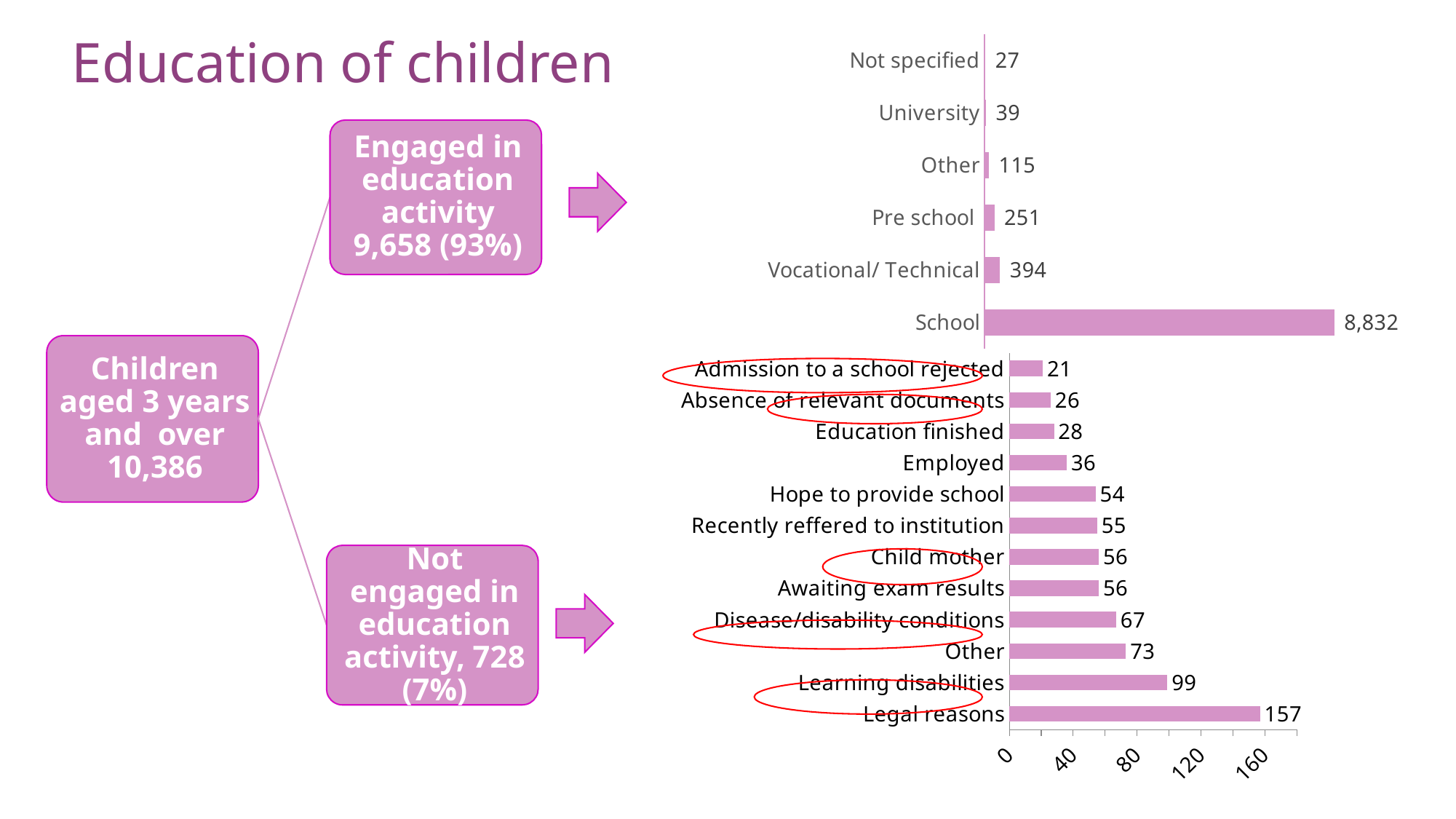
In the top chart, what is the value for Vocational/ Technical? 394 In the top chart, how many categories are shown? 6 In the bottom chart, what is the value for Disease/disability conditions? 67 In the top chart, what is the difference between Pre school and Other? 136 In the bottom chart, how many categories are shown? 12 In the top chart, what is the value for School? 8,832 What kind of chart is the bottom chart? Bar chart In the bottom chart, which is larger: Learning disabilities or Other? Learning disabilities In the top chart, which category has the lowest value? Not specified In the bottom chart, which category has the lowest value? Admission to a school rejected In the bottom chart, what is the value for Legal reasons? 157 In the bottom chart, what is the difference between Legal reasons and Learning disabilities? 58